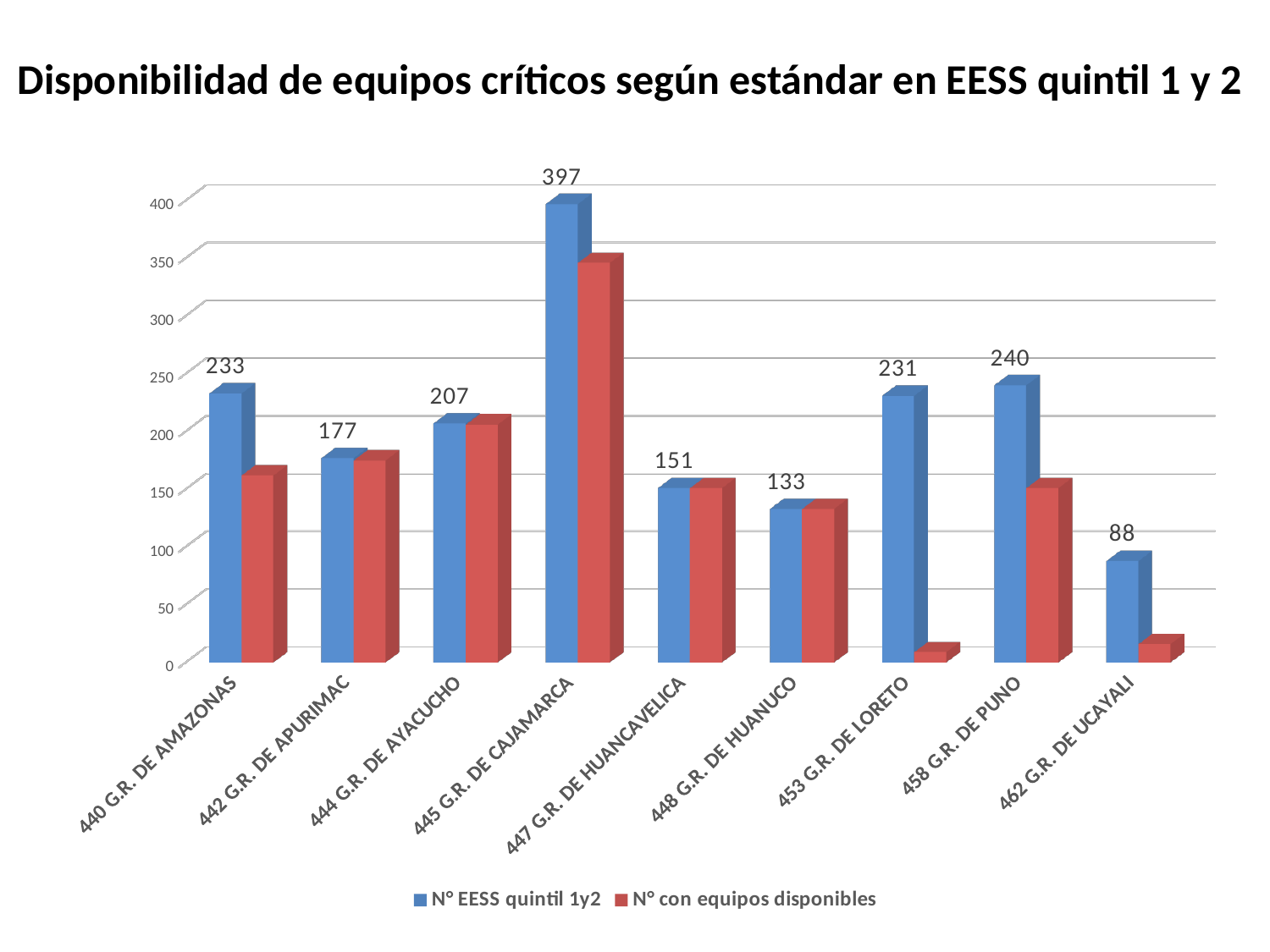
Which category has the highest value for N° EESS quintil 1y2? 445 G.R. DE CAJAMARCA How many categories are shown on the x axis? 9 Which category has the lowest value for N° EESS quintil 1y2? 462 G.R. DE UCAYALI Is the N° con equipos disponibles value for 445 G.R. DE CAJAMARCA greater or less than 300? greater What is the value of N° EESS quintil 1y2 for 444 G.R. DE AYACUCHO? 207 What is the value of N° EESS quintil 1y2 for 445 G.R. DE CAJAMARCA? 397 What is the value of N° EESS quintil 1y2 for 462 G.R. DE UCAYALI? 88 How many series does the legend list? 2 What is the difference between the N° EESS quintil 1y2 values for 445 G.R. DE CAJAMARCA and 462 G.R. DE UCAYALI? 309 What type of chart is shown on the slide? bar chart Which has a larger N° EESS quintil 1y2 value: 458 G.R. DE PUNO or 447 G.R. DE HUANCAVELICA? 458 G.R. DE PUNO Is the N° con equipos disponibles value for 453 G.R. DE LORETO greater or less than 50? less